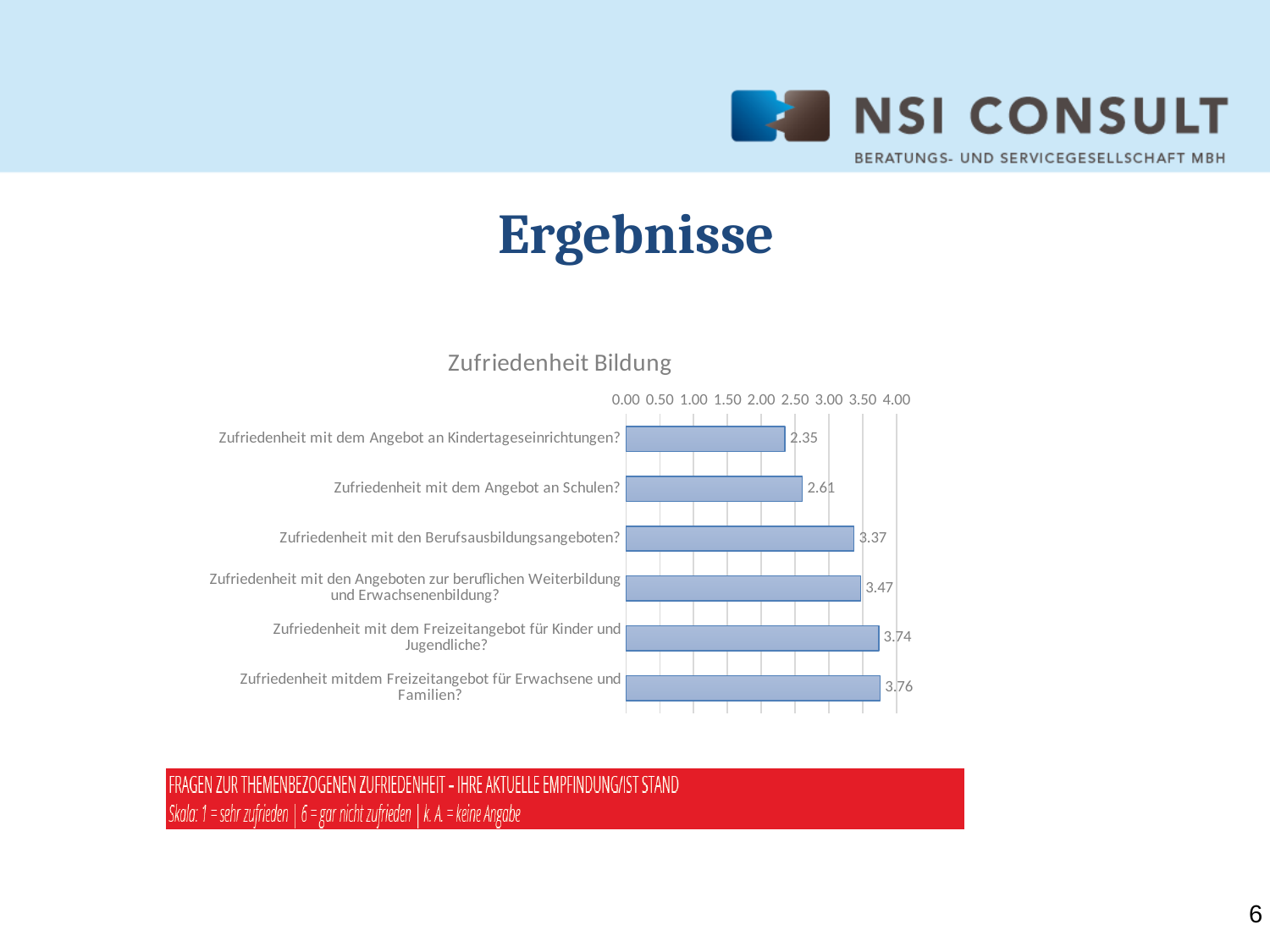
Which category has the highest value in the Zufriedenheit Bildung chart? Zufriedenheit mitdem Freizeitangebot für Erwachsene und Familien? Is the value for "Zufriedenheit mit dem Angebot an Schulen?" greater or less than 3.00? less What value is shown for "Zufriedenheit mit den Berufsausbildungsangeboten?"? 3.37 Which category has the lowest value in the Zufriedenheit Bildung chart? Zufriedenheit mit dem Angebot an Kindertageseinrichtungen? What is the difference between the values for "Zufriedenheit mit den Angeboten zur beruflichen Weiterbildung und Erwachsenenbildung?" and "Zufriedenheit mit dem Angebot an Schulen?"? 0.86 Which is larger: the value for "Zufriedenheit mit den Berufsausbildungsangeboten?" or for "Zufriedenheit mit dem Angebot an Kindertageseinrichtungen?"? Zufriedenheit mit den Berufsausbildungsangeboten? What is the value for "Zufriedenheit mit dem Angebot an Kindertageseinrichtungen?" in the Zufriedenheit Bildung chart? 2.35 What kind of chart is shown on the slide? bar chart How many categories are shown in the Zufriedenheit Bildung chart? 6 What is the value for "Zufriedenheit mit dem Angebot an Schulen?"? 2.61 What is the value for "Zufriedenheit mit dem Freizeitangebot für Kinder und Jugendliche?"? 3.74 What is the title of the chart on the slide? Zufriedenheit Bildung